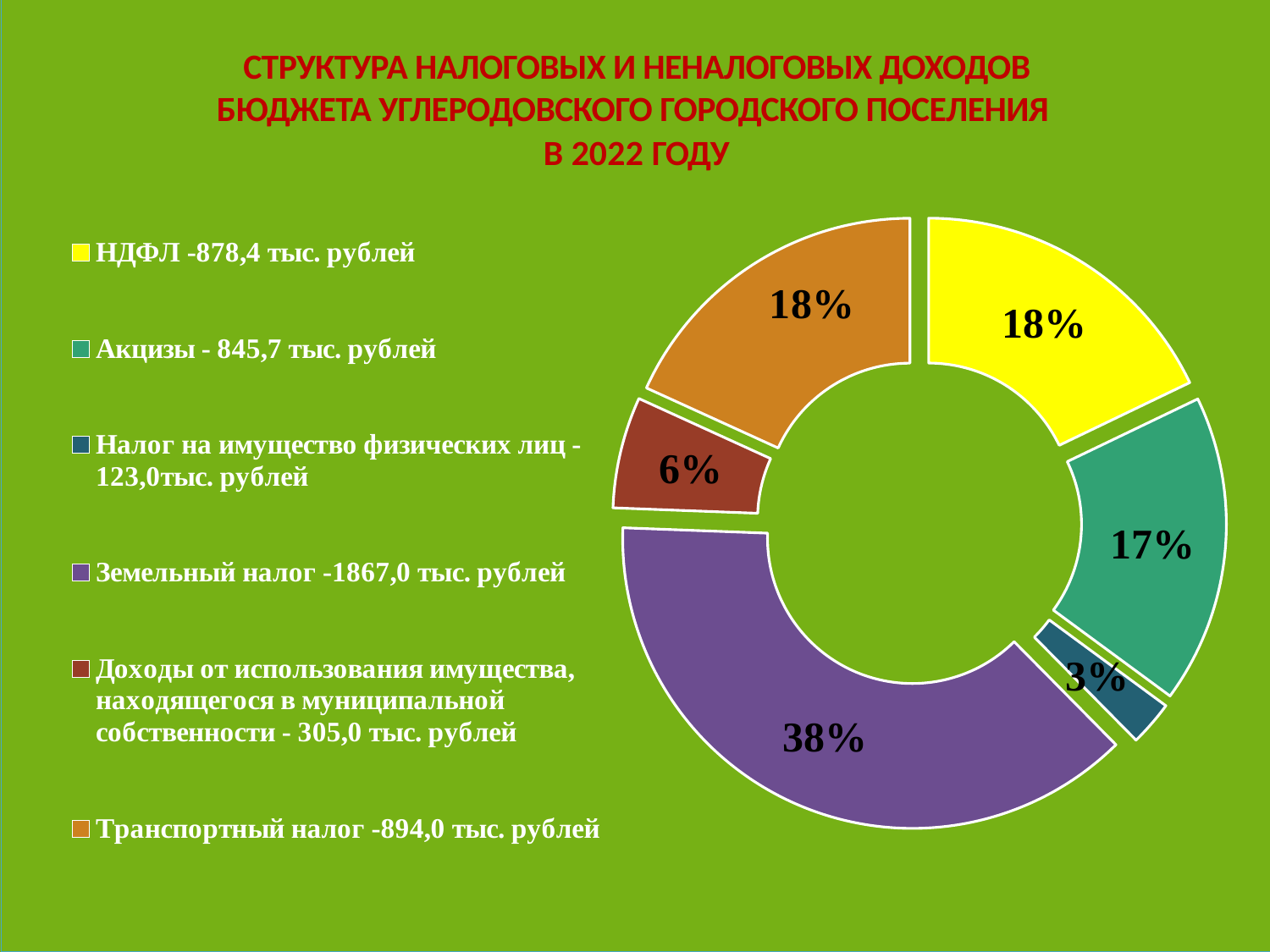
Which category has the smallest slice of the chart? Налог на имущество физических лиц What share of the doughnut chart does Акцизы account for? 17% According to the legend, what is the value for НДФЛ? 878,4 тыс. рублей Which has the larger share: Акцизы or Транспортный налог? Транспортный налог How many categories are shown in the chart? 6 According to the legend, what is the value for Транспортный налог? 894,0 тыс. рублей What share of the doughnut chart does Земельный налог account for? 38% What is the difference in percentage points between the share of Земельный налог and the share of Доходы от использования имущества, находящегося в муниципальной собственности? 32 percentage points What colour is the slice for Земельный налог? purple What kind of chart is shown on the slide? doughnut chart Which category has the largest slice of the chart? Земельный налог By how much does the value for Земельный налог exceed the value for НДФЛ, according to the legend? 988,6 тыс. рублей